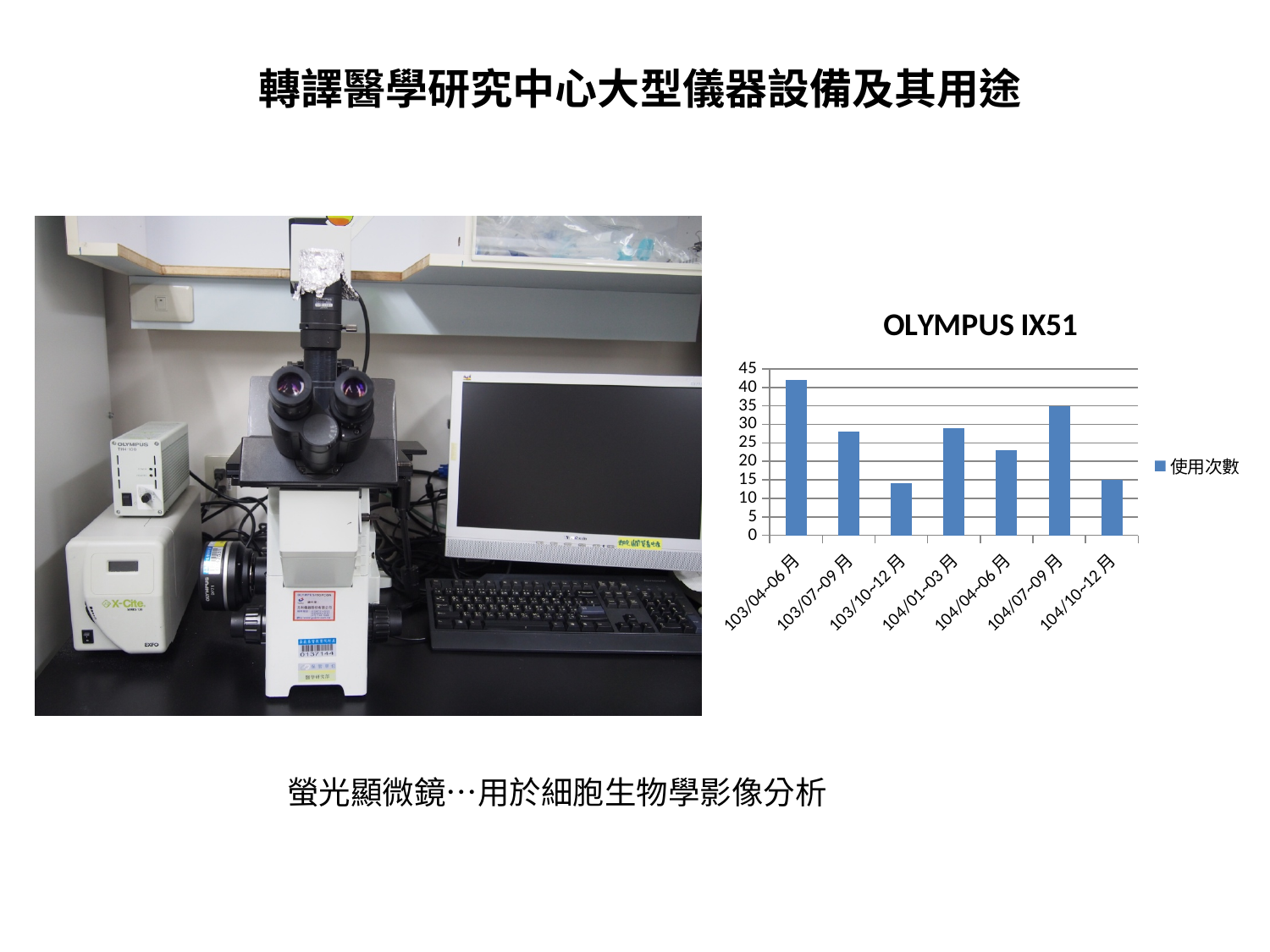
Is the value for 103/04~06月 greater or less than 40? greater Which period has the highest value in the OLYMPUS IX51 chart? 103/04~06月 What is the title of the chart on the slide? OLYMPUS IX51 How many series does the legend of the OLYMPUS IX51 chart list? 1 Is the value for 104/04~06月 greater or less than 20? greater Which is larger in the OLYMPUS IX51 chart, the value for 104/07~09月 or the value for 104/04~06月? 104/07~09月 What kind of chart is shown under the title OLYMPUS IX51? bar chart What is the name of the series in the legend of the OLYMPUS IX51 chart? 使用次數 How many categories are shown on the x axis of the OLYMPUS IX51 chart? 7 Is the value for 103/10~12月 greater or less than 20? less